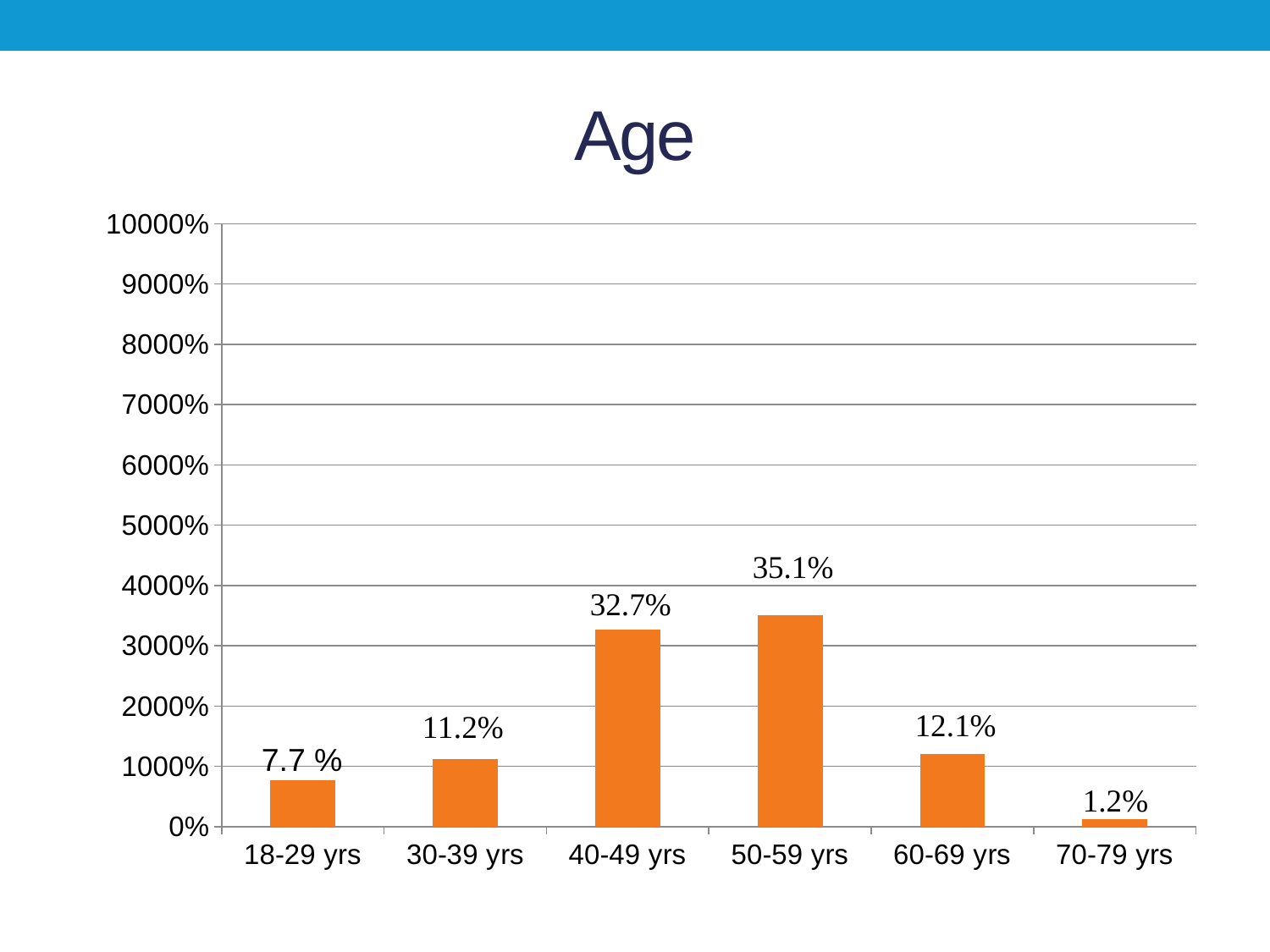
What kind of chart is shown on the slide? Bar chart What is the difference between the values for 60-69 yrs and 30-39 yrs? 0.9% What is the value for the 60-69 yrs category? 12.1% Which age group has the highest value? 50-59 yrs What is the difference between the values for 50-59 yrs and 40-49 yrs? 2.4% Do the values rise or fall from 50-59 yrs to 70-79 yrs? Fall Which is larger, the value for 30-39 yrs or the value for 60-69 yrs? 60-69 yrs What is the value for the 70-79 yrs category? 1.2% Which age group has the lowest value? 70-79 yrs How many age categories are shown on the x axis? 6 What is the value for the 40-49 yrs category? 32.7% What is the value for the 18-29 yrs category? 7.7 %